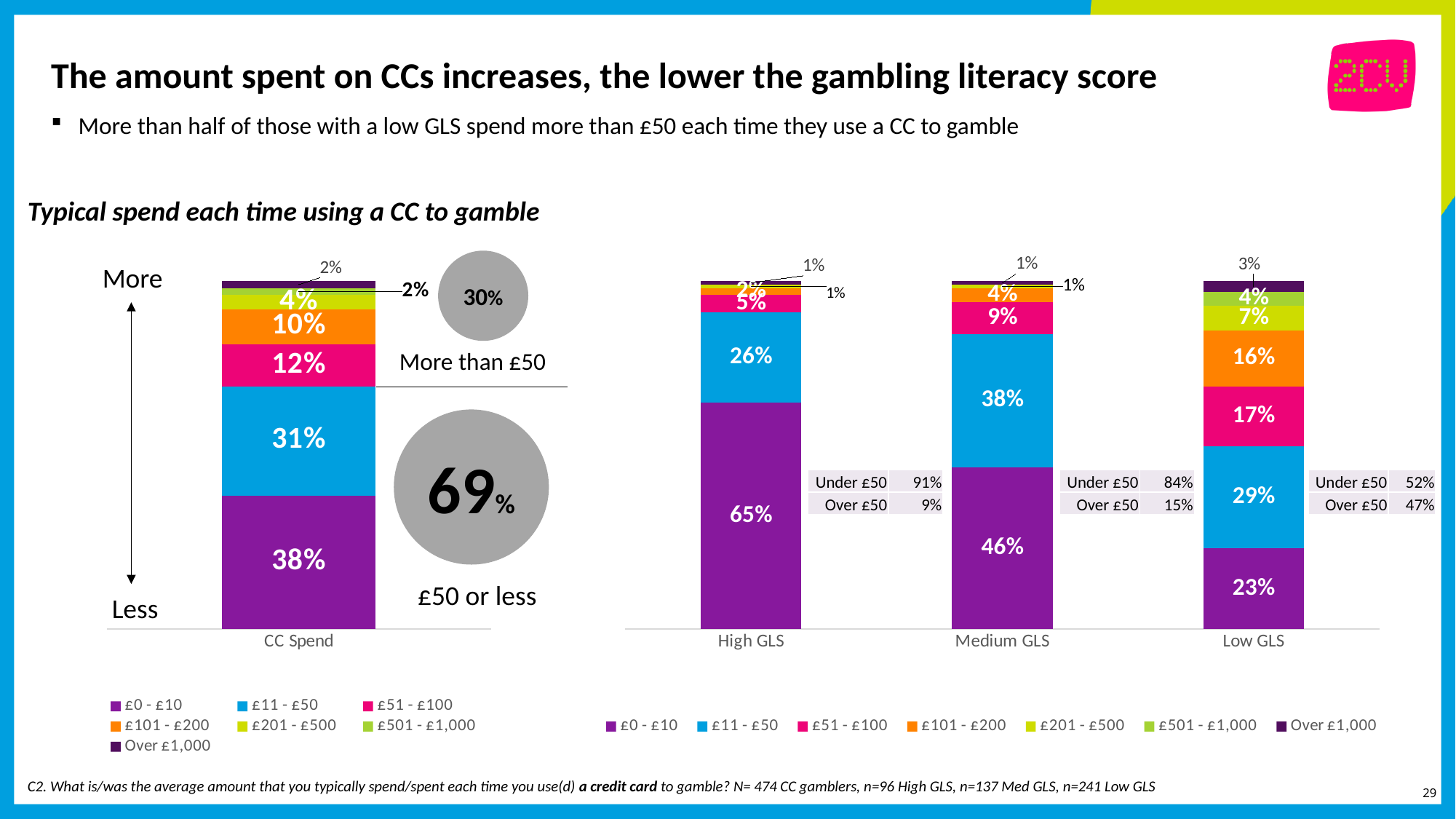
In the right chart, which GLS group has the largest £0 - £10 segment? High GLS In the right chart, is the £101 - £200 segment larger for Low GLS or Medium GLS? Low GLS How many categories are shown on the x axis of the right chart? 3 In the left chart (CC Spend), what percentage is shown for the £11 - £50 segment? 31% How many series does the legend of the right chart list? 7 What type of chart is the left chart (CC Spend)? Stacked bar chart In the left chart (CC Spend), what percentage is shown for the £0 - £10 segment? 38% In the right chart, which GLS group has the smallest £0 - £10 segment? Low GLS In the right chart, what percentage of the High GLS bar is the £0 - £10 segment? 65% In the right chart, what is the difference between the £51 - £100 segments for Low GLS and High GLS? 12% In the right chart, what percentage of the Medium GLS bar is the £11 - £50 segment? 38% In the right chart, what percentage of the Low GLS bar is the £0 - £10 segment? 23%